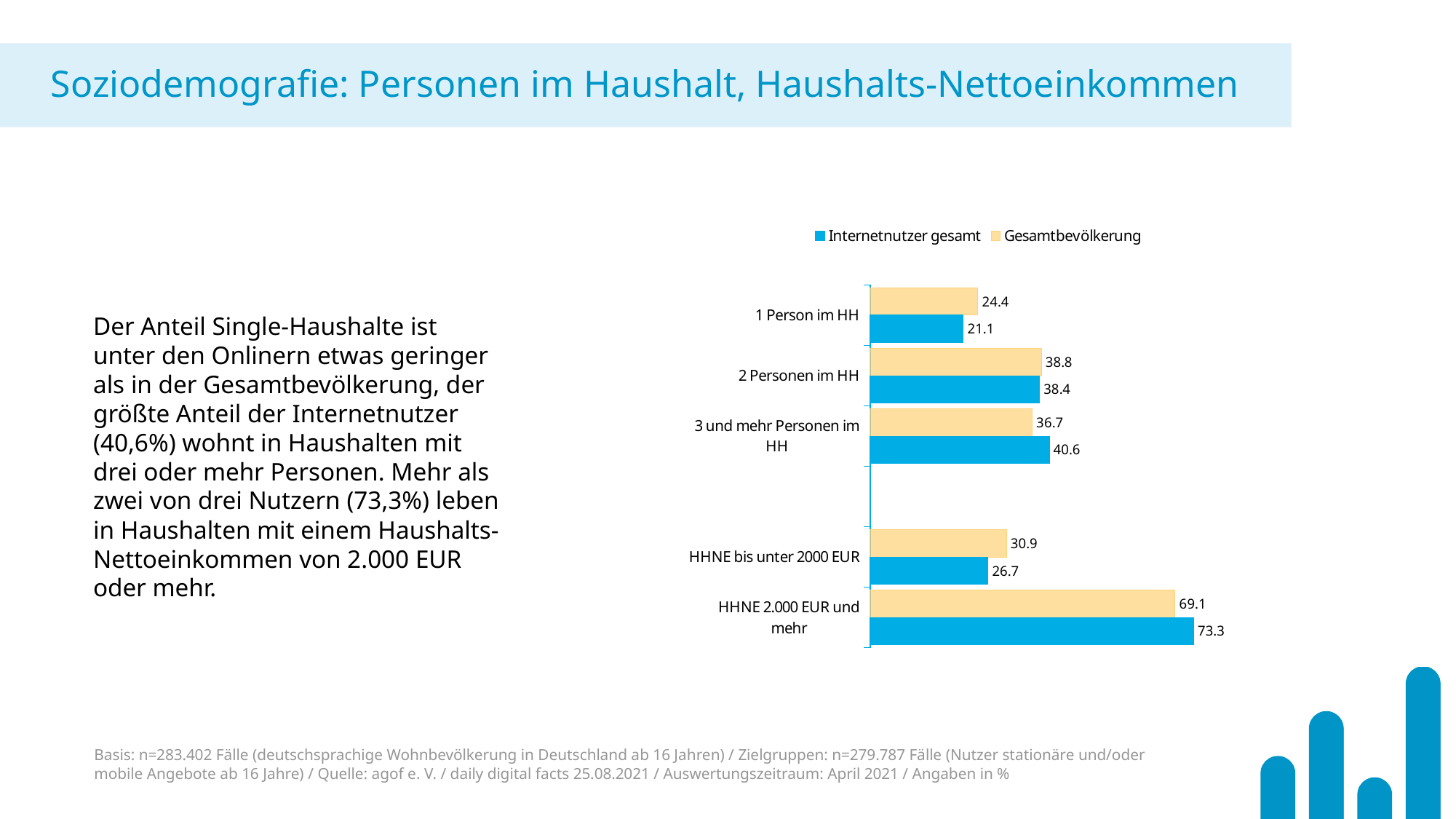
How many categories are shown on the chart? 5 What is the value for Gesamtbevölkerung in the category 3 und mehr Personen im HH? 36.7 What is the difference between the Gesamtbevölkerung and Internetnutzer gesamt values for HHNE bis unter 2000 EUR? 4.2 Which category has the highest value for Internetnutzer gesamt? HHNE 2.000 EUR und mehr Which is larger for 1 Person im HH: Internetnutzer gesamt or Gesamtbevölkerung? Gesamtbevölkerung Which category has the lowest value for Gesamtbevölkerung? 1 Person im HH How many series does the legend list? 2 Which colour represents the Gesamtbevölkerung series? Light yellow What is the value for Internetnutzer gesamt in the category 1 Person im HH? 21.1 Which is larger for 3 und mehr Personen im HH: Internetnutzer gesamt or Gesamtbevölkerung? Internetnutzer gesamt What kind of chart is shown on the slide? Bar chart What is the value for Gesamtbevölkerung in the category HHNE 2.000 EUR und mehr? 69.1